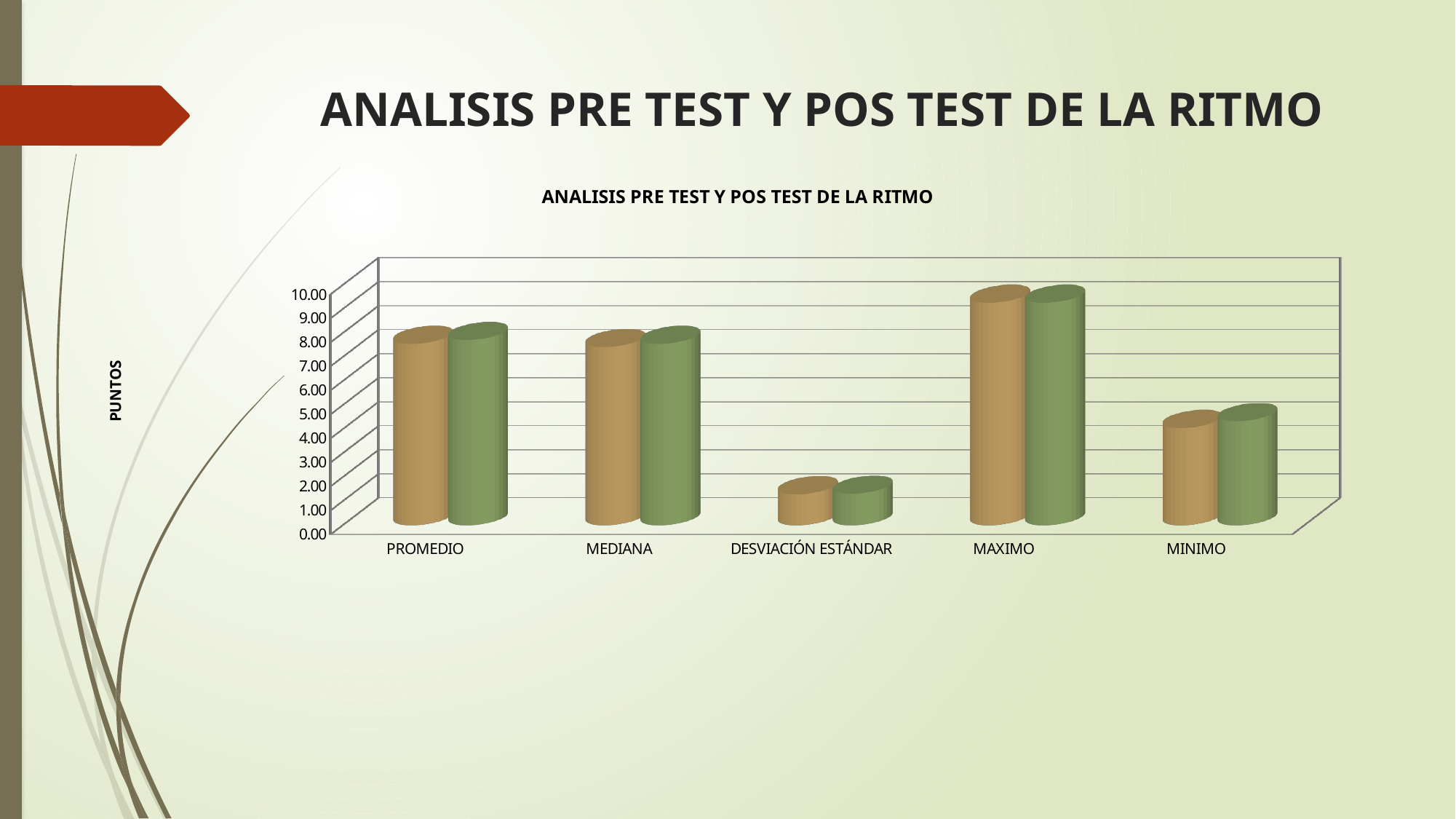
What is the label on the vertical axis of the chart? PUNTOS Which is larger, the green bar for PROMEDIO or the green bar for DESVIACIÓN ESTÁNDAR? PROMEDIO Is the value of the brown bar for PROMEDIO greater or less than 6.00? greater What kind of chart is shown on the slide? bar chart Which category has the lowest bars in the chart? DESVIACIÓN ESTÁNDAR What is the title of the chart? ANALISIS PRE TEST Y POS TEST DE LA RITMO Is the value of the brown bar for MAXIMO greater or less than 8.00? greater Which category has the highest bars in the chart? MAXIMO How many categories are shown on the x axis of the chart? 5 Is the value of the brown bar for DESVIACIÓN ESTÁNDAR greater or less than 3.00? less Which is larger, the brown bar for MAXIMO or the brown bar for MINIMO? MAXIMO